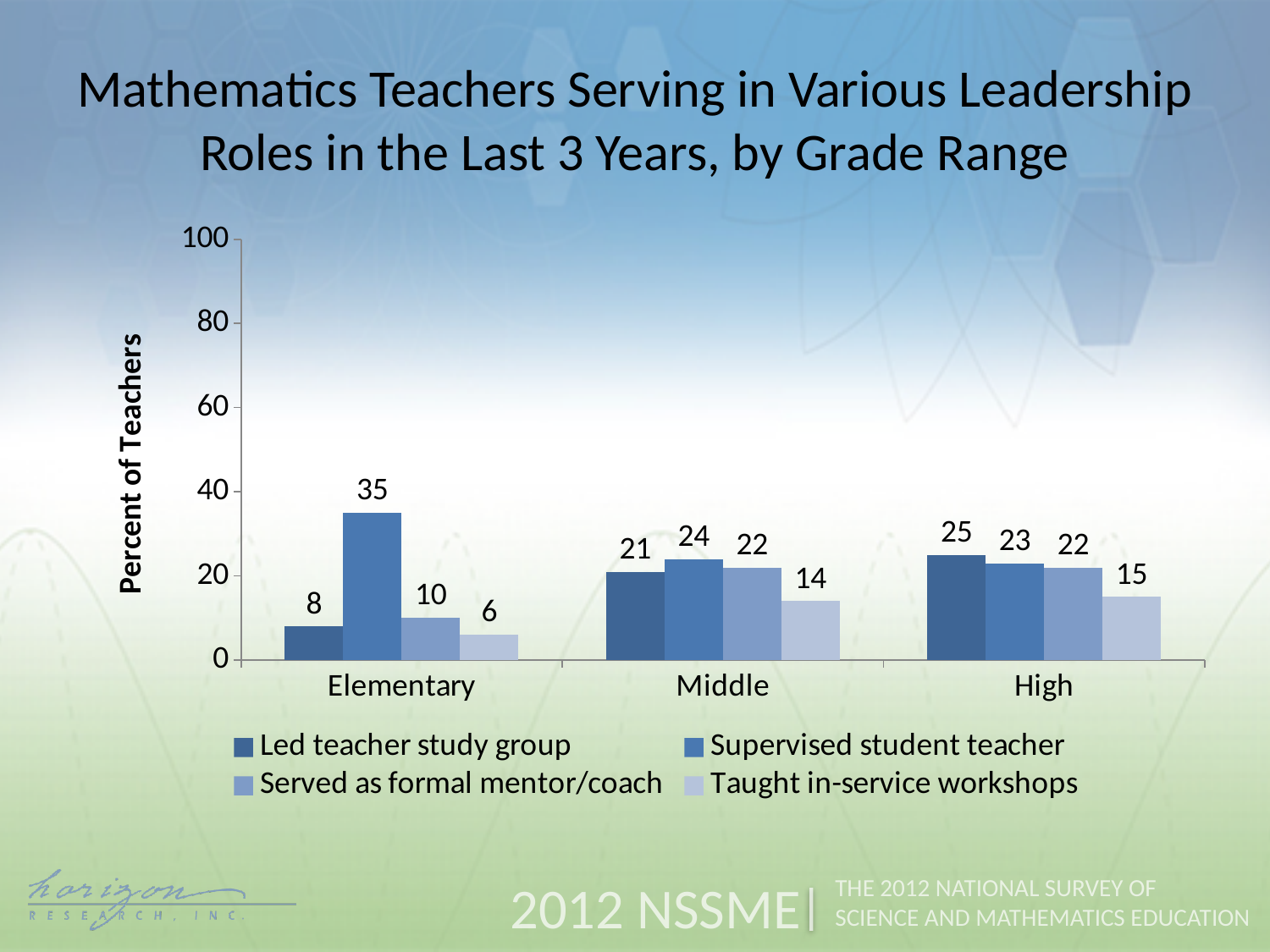
What is the difference between the percentage of elementary teachers who supervised a student teacher and those who taught in-service workshops? 29 How many series does the legend list? 4 Is the percentage of elementary teachers who served as a formal mentor/coach greater or less than 20? less Which leadership role has the highest percentage among elementary teachers? Supervised student teacher What kind of chart is shown on the slide? Bar chart What percent of elementary mathematics teachers supervised a student teacher? 35 What percent of middle school mathematics teachers taught in-service workshops? 14 How many grade ranges are shown on the x axis? 3 Which is larger: the percentage of middle school teachers who led a teacher study group or the percentage of high school teachers who led a teacher study group? High What percent of high school mathematics teachers led a teacher study group? 25 Which grade range has the lowest percentage of teachers who led a teacher study group? Elementary What is the label of the y axis? Percent of Teachers